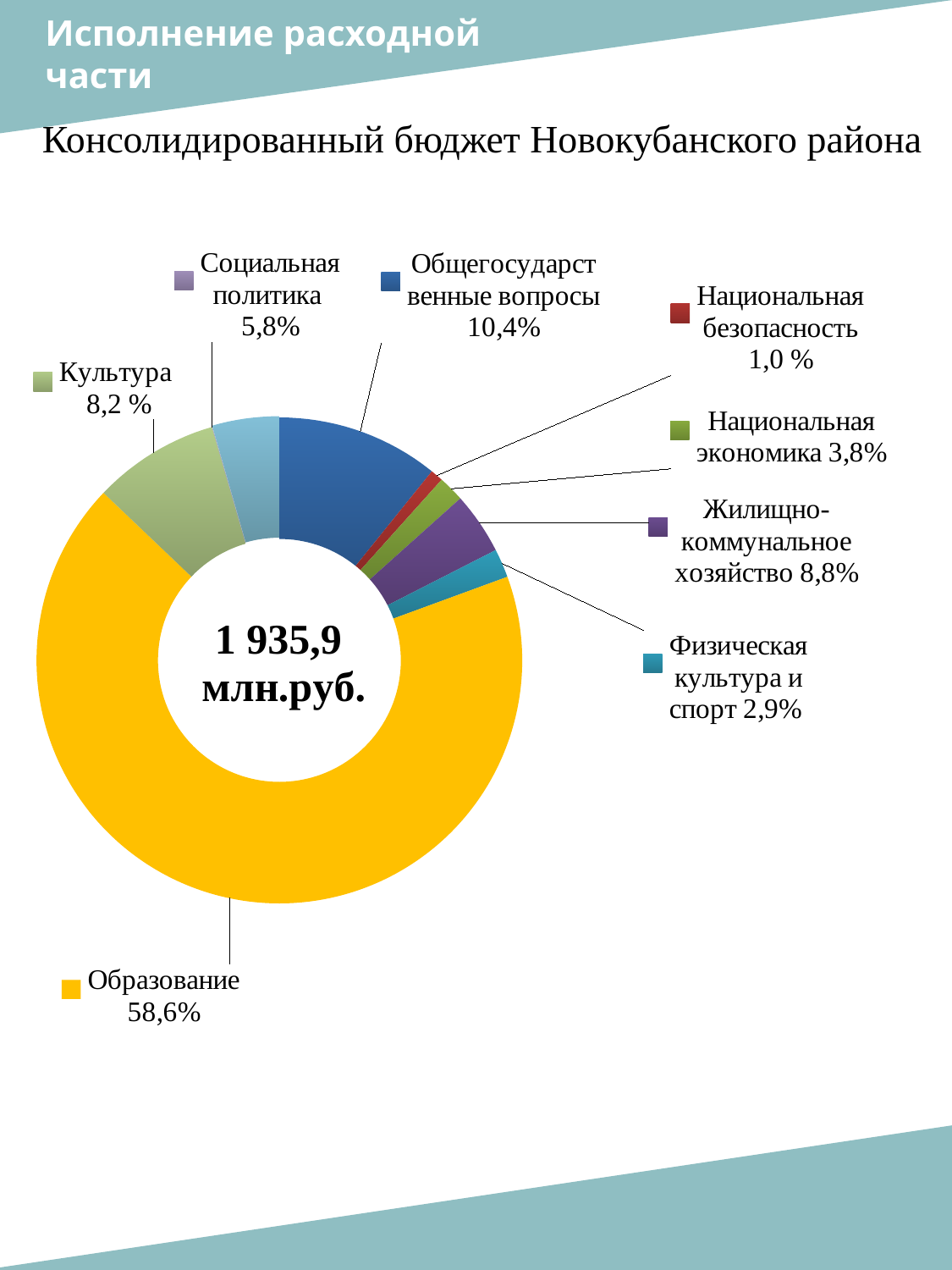
What share of the budget goes to Общегосударственные вопросы? 10,4% Which category has the smallest share of the budget? Национальная безопасность How many categories are shown in the chart? 8 What type of chart is shown on the slide? doughnut (pie) chart What share of the budget goes to Национальная безопасность? 1,0 % What is the title above the chart? Консолидированный бюджет Новокубанского района What share of the budget goes to Жилищно-коммунальное хозяйство? 8,8% Which is larger: the share for Культура or the share for Социальная политика? Культура Which category has the largest share of the budget? Образование What total amount is shown in the centre of the chart? 1 935,9 млн.руб. What share of the budget goes to Образование? 58,6% What is the difference between the shares of Общегосударственные вопросы and Физическая культура и спорт? 7,5%